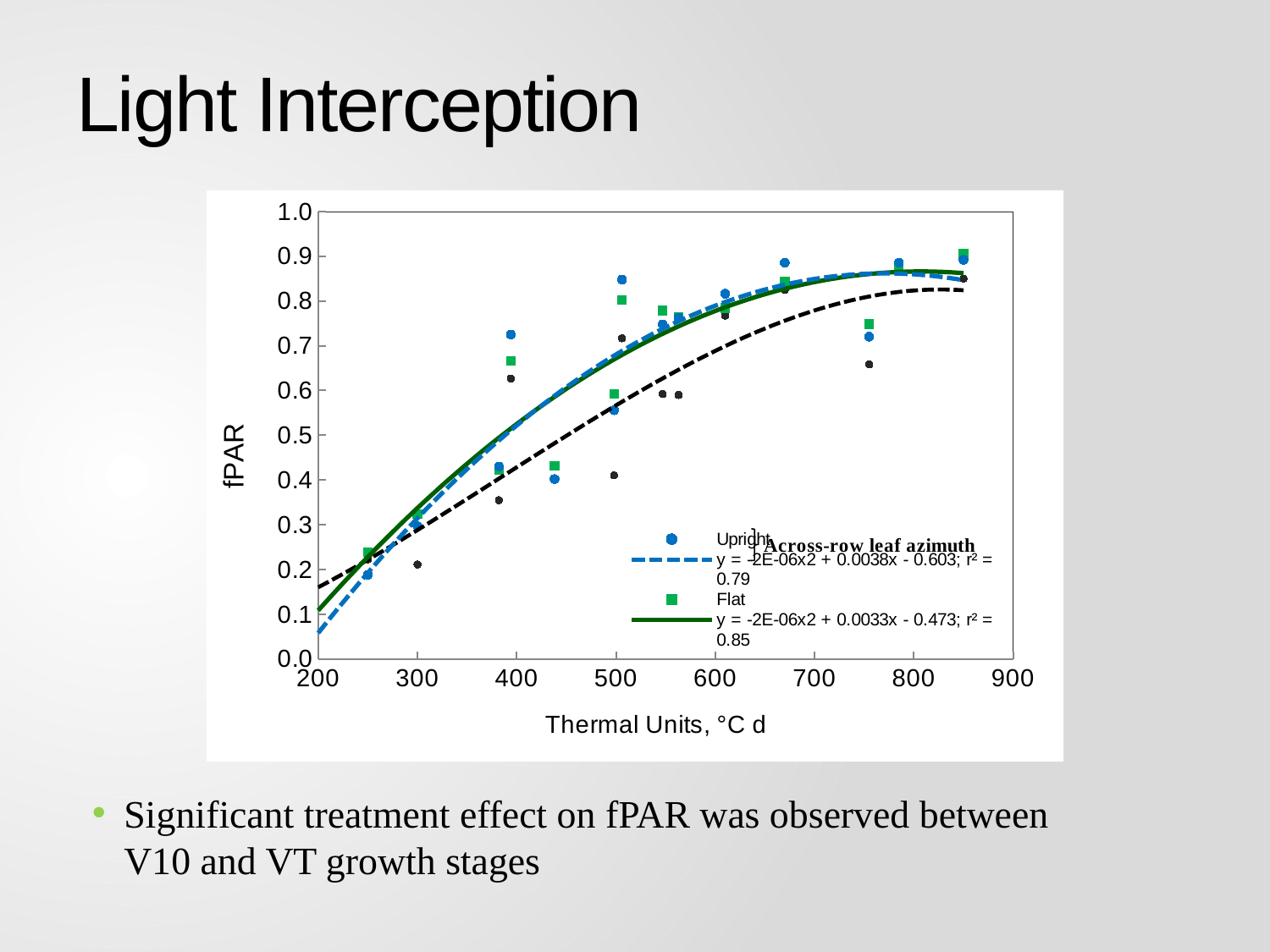
What r² value is given for the Upright trendline? 0.79 What is the highest value shown on the x axis? 900 Which trendline has the higher r², Upright or Flat? Flat What is the title of the y axis? fPAR What equation is given for the Upright trendline? y = -2E-06x2 + 0.0038x - 0.603 Is the Upright fPAR value at about 670 thermal units greater or less than 0.8? greater What r² value is given for the Flat trendline? 0.85 What is the title of the x axis? Thermal Units, °C d What is the difference between the r² values of the Flat and Upright trendlines? 0.06 Is the Flat fPAR value at about 300 thermal units greater or less than 0.5? less What kind of chart is shown on the slide? scatter chart Does fPAR generally rise or fall as thermal units increase? rise